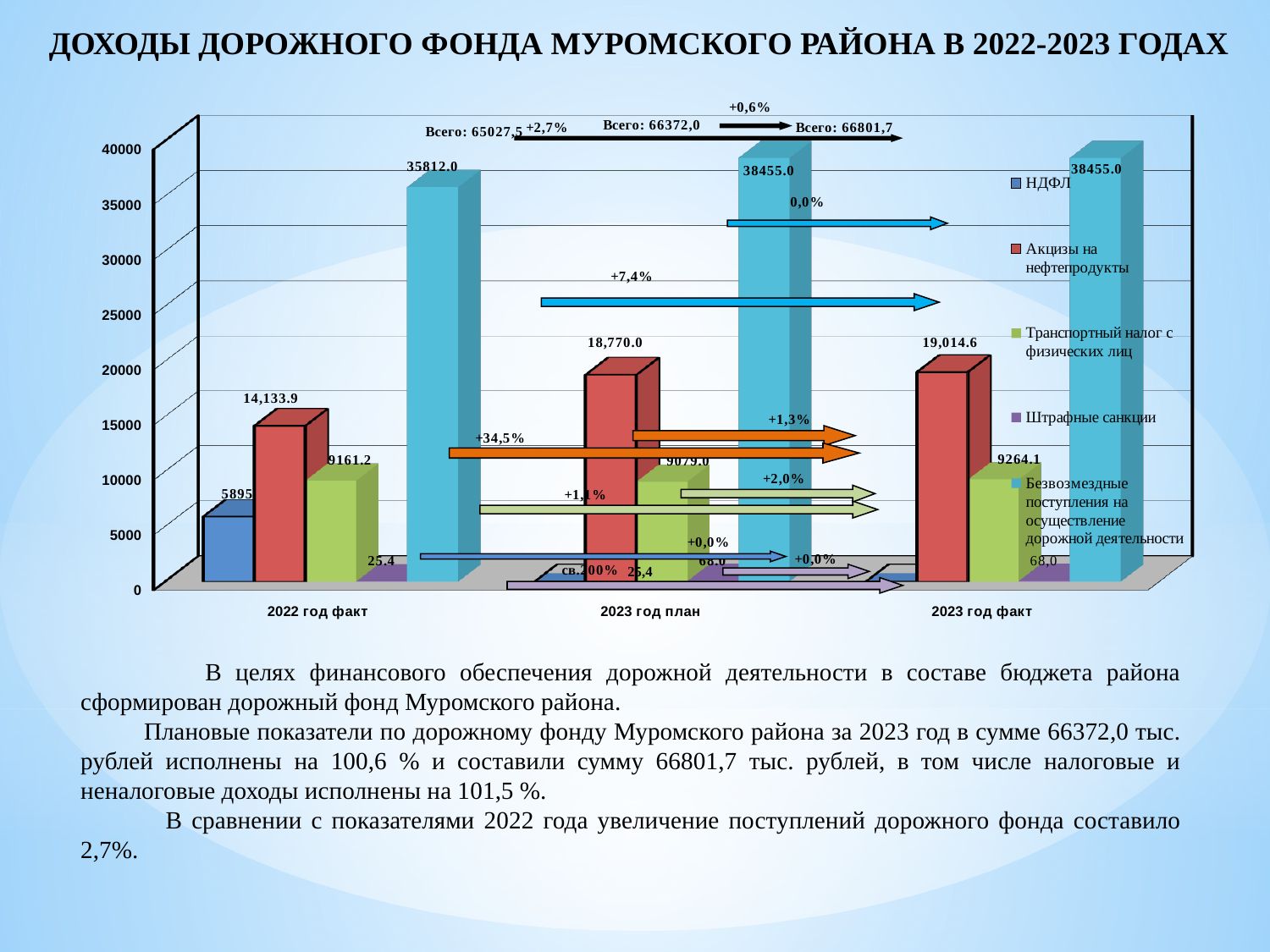
How many series does the legend list? 5 What is the value of Транспортный налог с физических лиц for 2022 год факт? 9161.2 What is the value of Акцизы на нефтепродукты for 2023 год план? 18,770.0 How many categories are shown on the x axis? 3 Which is larger: Акцизы на нефтепродукты in 2023 год факт or in 2022 год факт? 2023 год факт What is the value of Акцизы на нефтепродукты for 2023 год факт? 19,014.6 What type of chart is shown on the slide? bar chart Which series has the highest value in 2023 год факт? Безвозмездные поступления на осуществление дорожной деятельности What is the value of Безвозмездные поступления на осуществление дорожной деятельности for 2022 год факт? 35812.0 What is the value of НДФЛ for 2022 год факт? 5895 Is the value of Безвозмездные поступления for 2023 год план greater or less than 35000? greater What is the total (Всего) shown for 2023 год факт? 66801,7